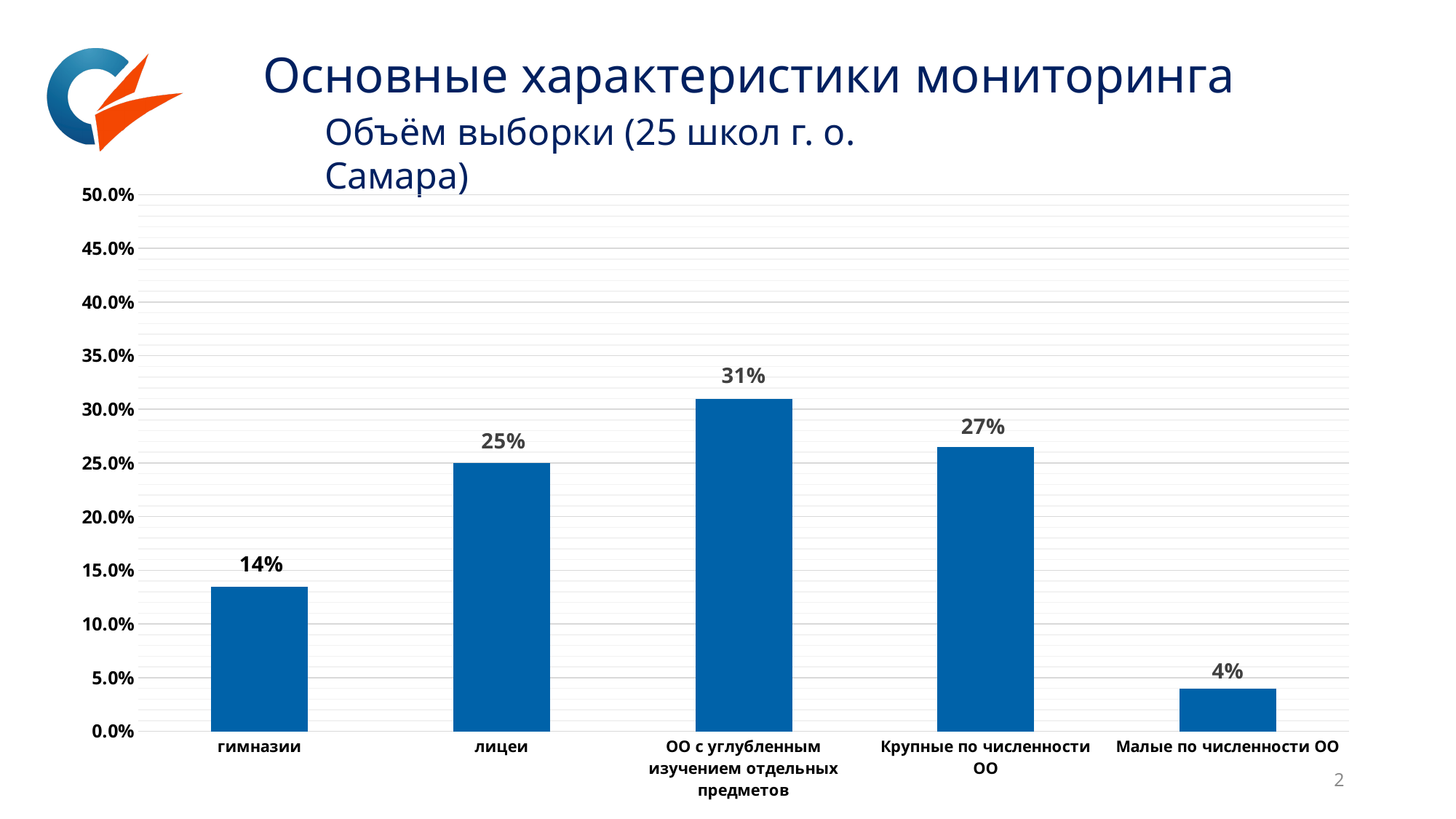
Is the value for Крупные по численности ОО greater or less than 30.0%? less What kind of chart is shown on the slide? bar chart What is the title of the chart? Объём выборки (25 школ г. о. Самара) What is the value for Малые по численности ОО? 4% What is the value for лицеи? 25% What is the value for ОО с углубленным изучением отдельных предметов? 31% What is the difference between the values for лицеи and гимназии? 11% Which category has the lowest value? Малые по численности ОО What is the value for гимназии? 14% How many categories are shown on the chart? 5 Which category has the highest value? ОО с углубленным изучением отдельных предметов Which is larger, the value for Крупные по численности ОО or the value for лицеи? Крупные по численности ОО